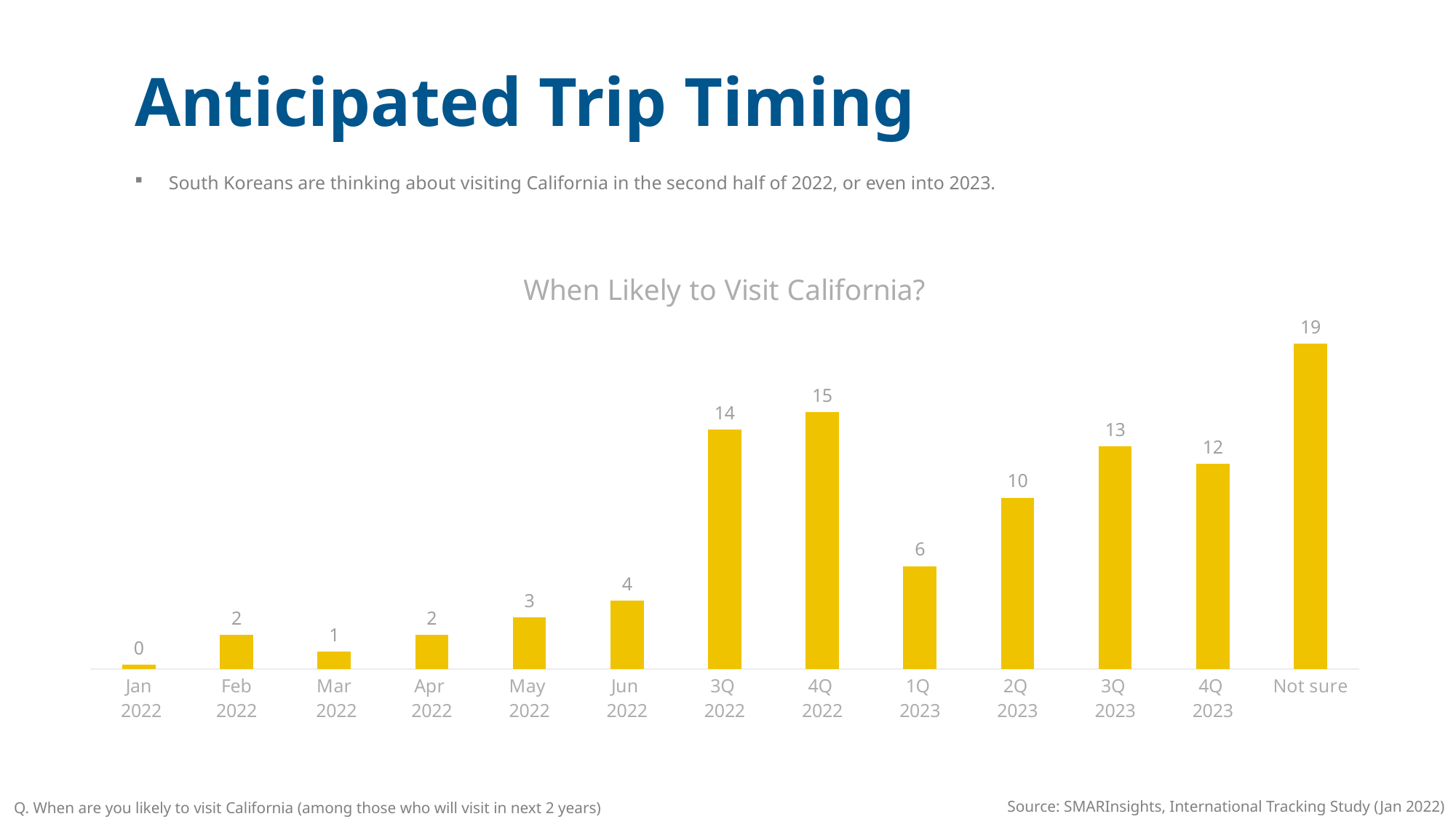
What is the value for 1Q 2023? 6 What is the difference between the values for 4Q 2022 and 1Q 2023? 9 Which is larger, the value for 3Q 2022 or the value for 3Q 2023? 3Q 2022 Which category has the lowest value? Jan 2022 What is the value for Jun 2022? 4 Which category has the highest value? Not sure How many categories are shown on the x axis? 13 What colour are the bars in the chart? Yellow What is the title of the chart? When Likely to Visit California? What kind of chart is shown on the slide? Bar chart What is the value for 4Q 2022? 15 Do the values rise or fall from Jan 2022 to 4Q 2022? Rise